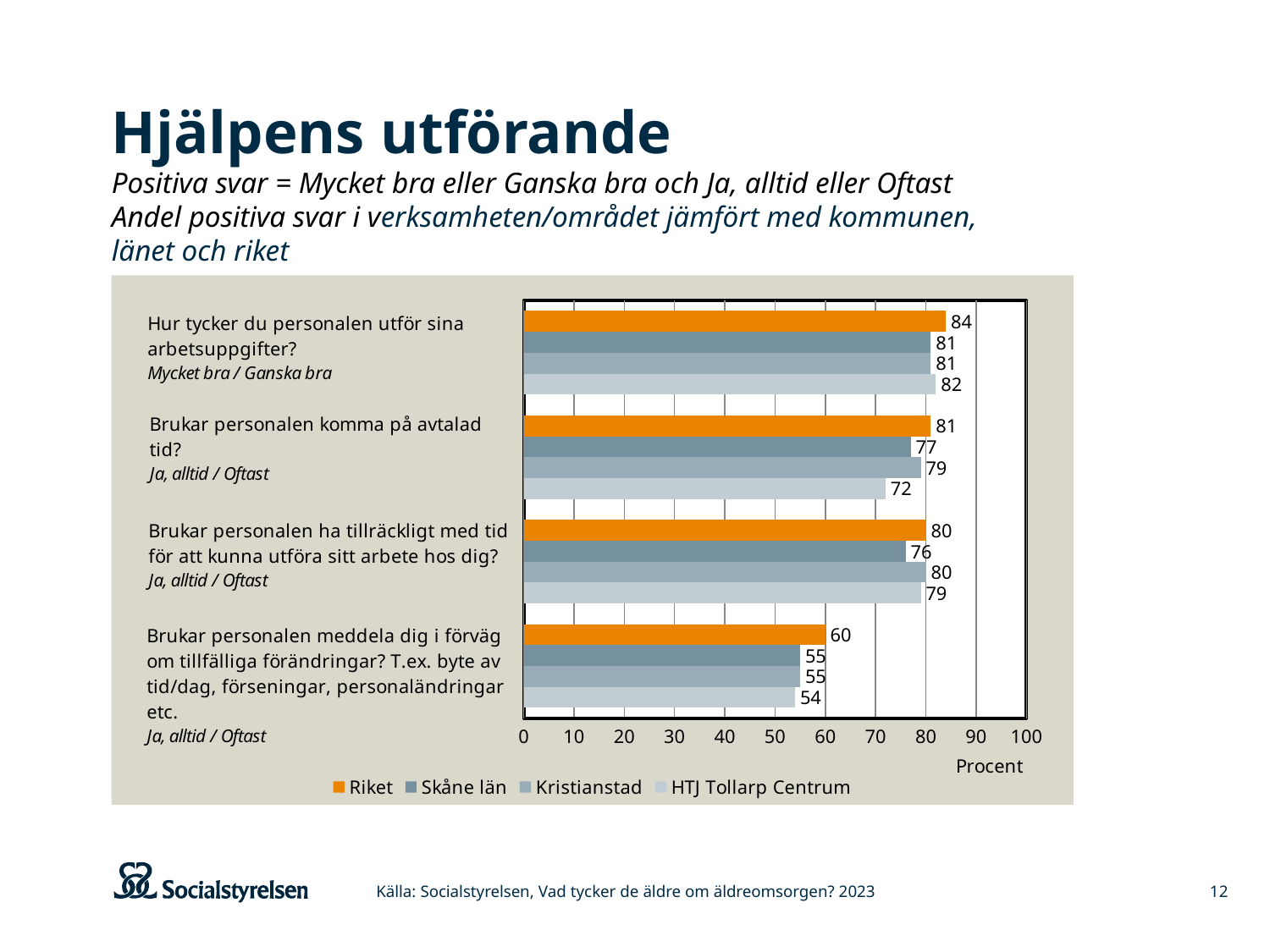
What is the value for HTJ Tollarp Centrum on the question "Brukar personalen komma på avtalad tid?"? 72 What is the difference between Riket and HTJ Tollarp Centrum on the question "Brukar personalen komma på avtalad tid?"? 9 What is the value for Kristianstad on the question "Brukar personalen meddela dig i förväg om tillfälliga förändringar?"? 55 What is the value for Skåne län on the question "Brukar personalen ha tillräckligt med tid för att kunna utföra sitt arbete hos dig?"? 76 Which series has the lowest value on the question "Brukar personalen meddela dig i förväg om tillfälliga förändringar?"? HTJ Tollarp Centrum What is the label on the horizontal axis of the chart? Procent What type of chart is shown on the slide? Bar chart On the question "Brukar personalen ha tillräckligt med tid för att kunna utföra sitt arbete hos dig?", which is larger: Kristianstad or HTJ Tollarp Centrum? Kristianstad How many series does the legend list? 4 Which series has the highest value on the question "Brukar personalen komma på avtalad tid?"? Riket What is the value for Riket on the question "Hur tycker du personalen utför sina arbetsuppgifter?"? 84 How many questions (categories) are plotted in the chart? 4